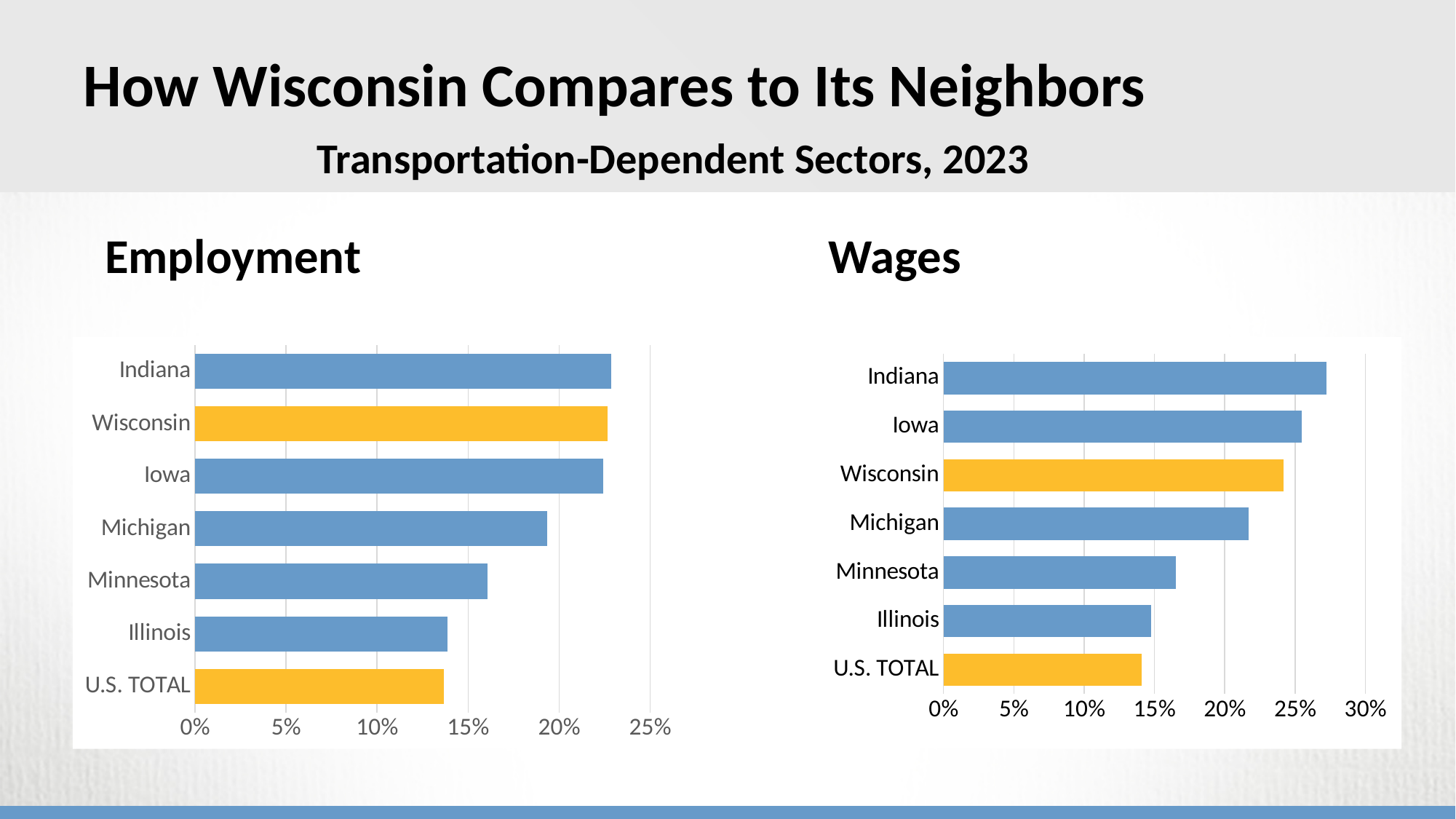
In the Wages chart, is the value for Michigan greater or less than 20%? greater In the Wages chart, which is larger, Iowa or Michigan? Iowa In the Employment chart, is the value for Michigan greater or less than 15%? greater In the Employment chart, which is larger, Michigan or Minnesota? Michigan In the Wages chart, is the value for Indiana greater or less than 25%? greater In the Employment chart, what colour is the Wisconsin bar? yellow How many states or totals are shown in the Wages chart? 7 In the Wages chart, which has the highest value? Indiana What kind of chart is the Employment chart? bar chart